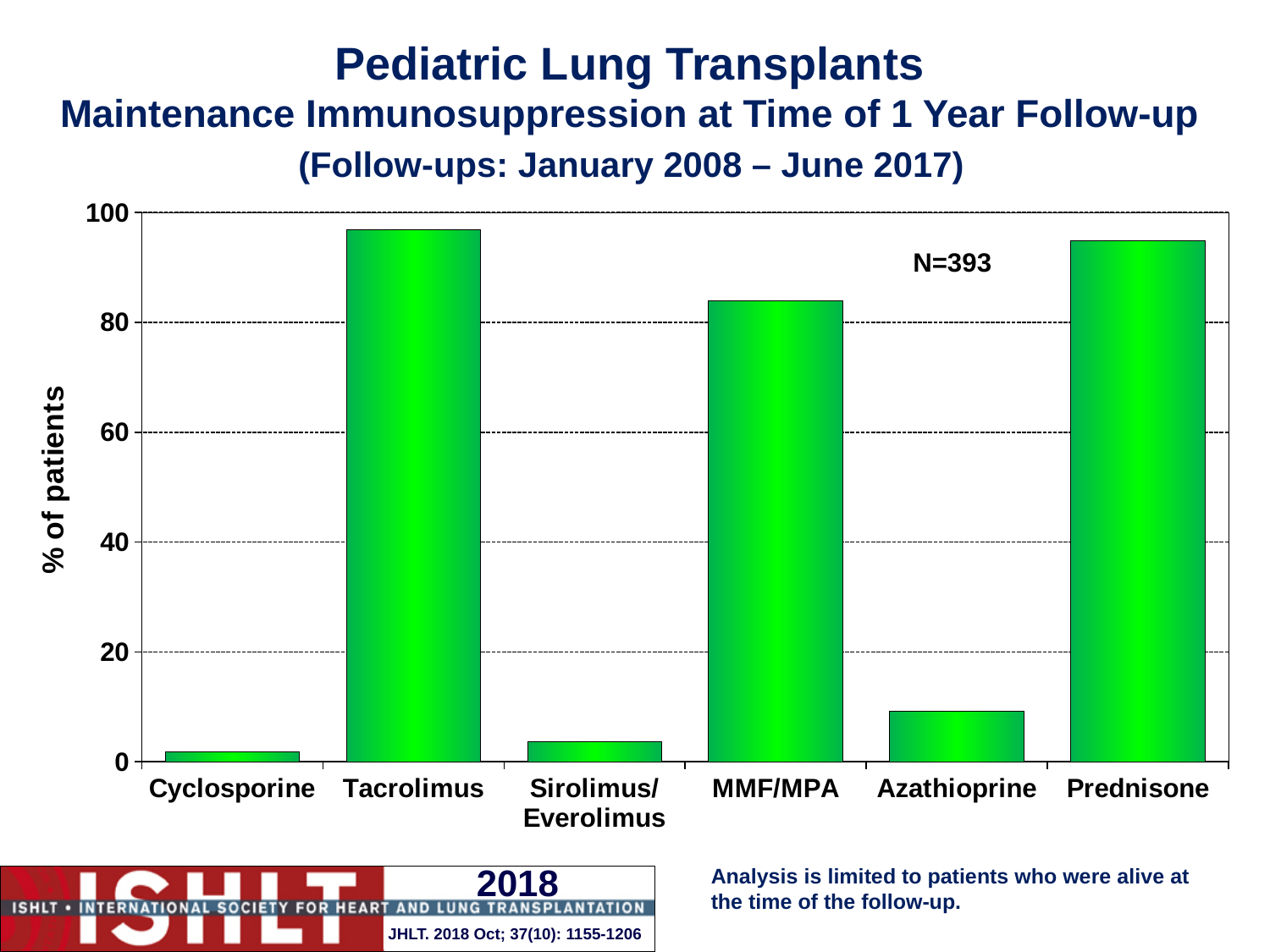
Is the value for Azathioprine greater or less than 20? less Which is larger, the value for Tacrolimus or the value for Azathioprine? Tacrolimus Which is larger, the value for MMF/MPA or the value for Cyclosporine? MMF/MPA How many drug categories are shown on the x axis? 6 Is the value for Cyclosporine greater or less than 20? less What sample size (N) is printed on the chart? N=393 What is the label of the y axis? % of patients Is the value for Tacrolimus greater or less than 80? greater What kind of chart is shown on the slide? bar chart